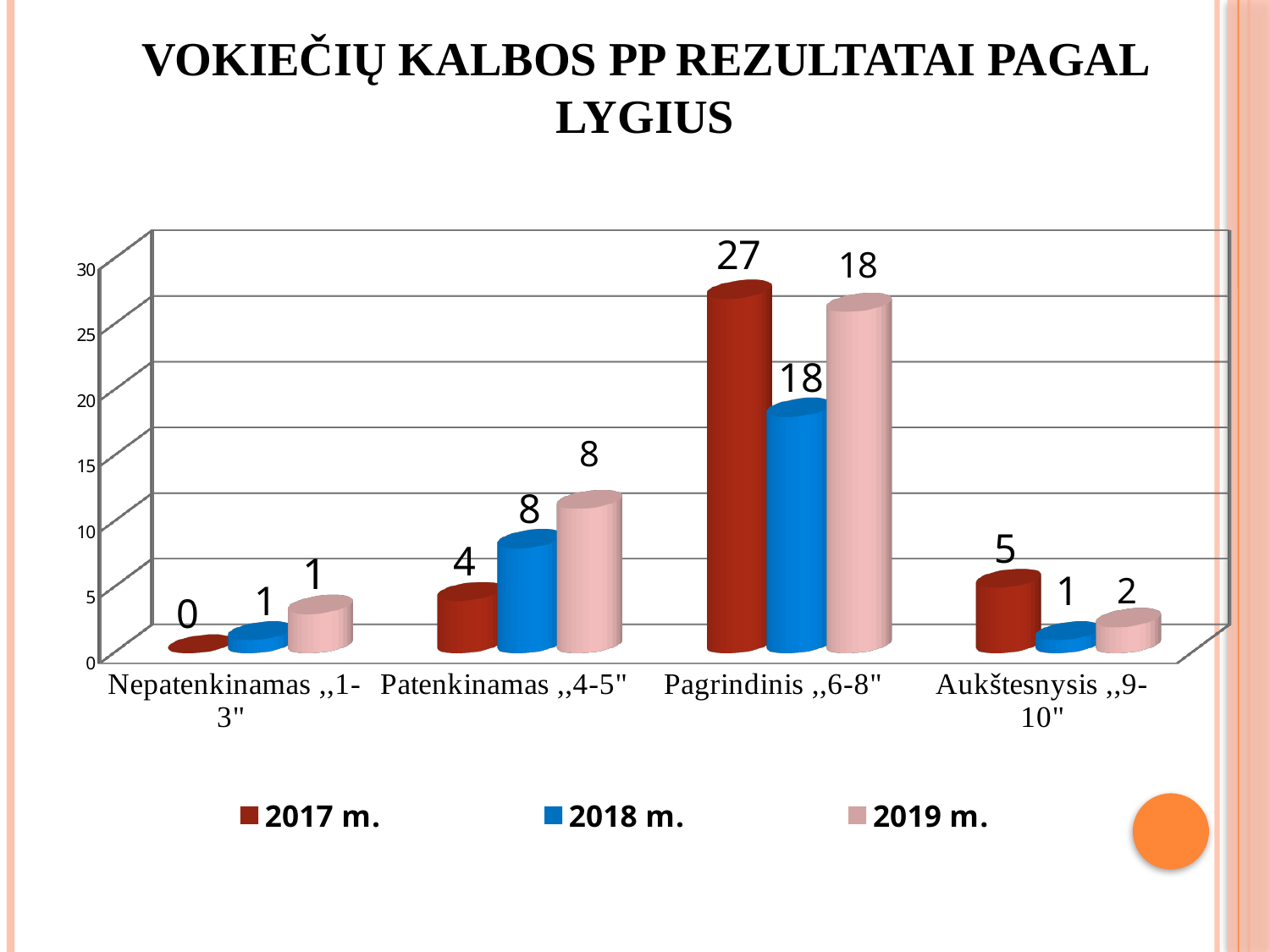
What is the value for 2017 m. in the Nepatenkinamas ,,1-3" category? 0 What is the value for 2019 m. in the Patenkinamas ,,4-5" category? 8 How many series does the legend list? 3 What is the value for 2017 m. in the Pagrindinis ,,6-8" category? 27 What is the title of the chart? VOKIEČIŲ KALBOS PP REZULTATAI PAGAL LYGIUS What kind of chart is shown on the slide? Bar chart Which category has the lowest value for 2017 m.? Nepatenkinamas ,,1-3" How many categories are shown on the x axis? 4 What is the value for 2018 m. in the Aukštesnysis ,,9-10" category? 1 Which is larger in the Aukštesnysis ,,9-10" category: the 2017 m. value or the 2019 m. value? 2017 m. What is the difference between the 2017 m. and 2018 m. values in the Pagrindinis ,,6-8" category? 9 Which category has the highest value for 2018 m.? Pagrindinis ,,6-8"